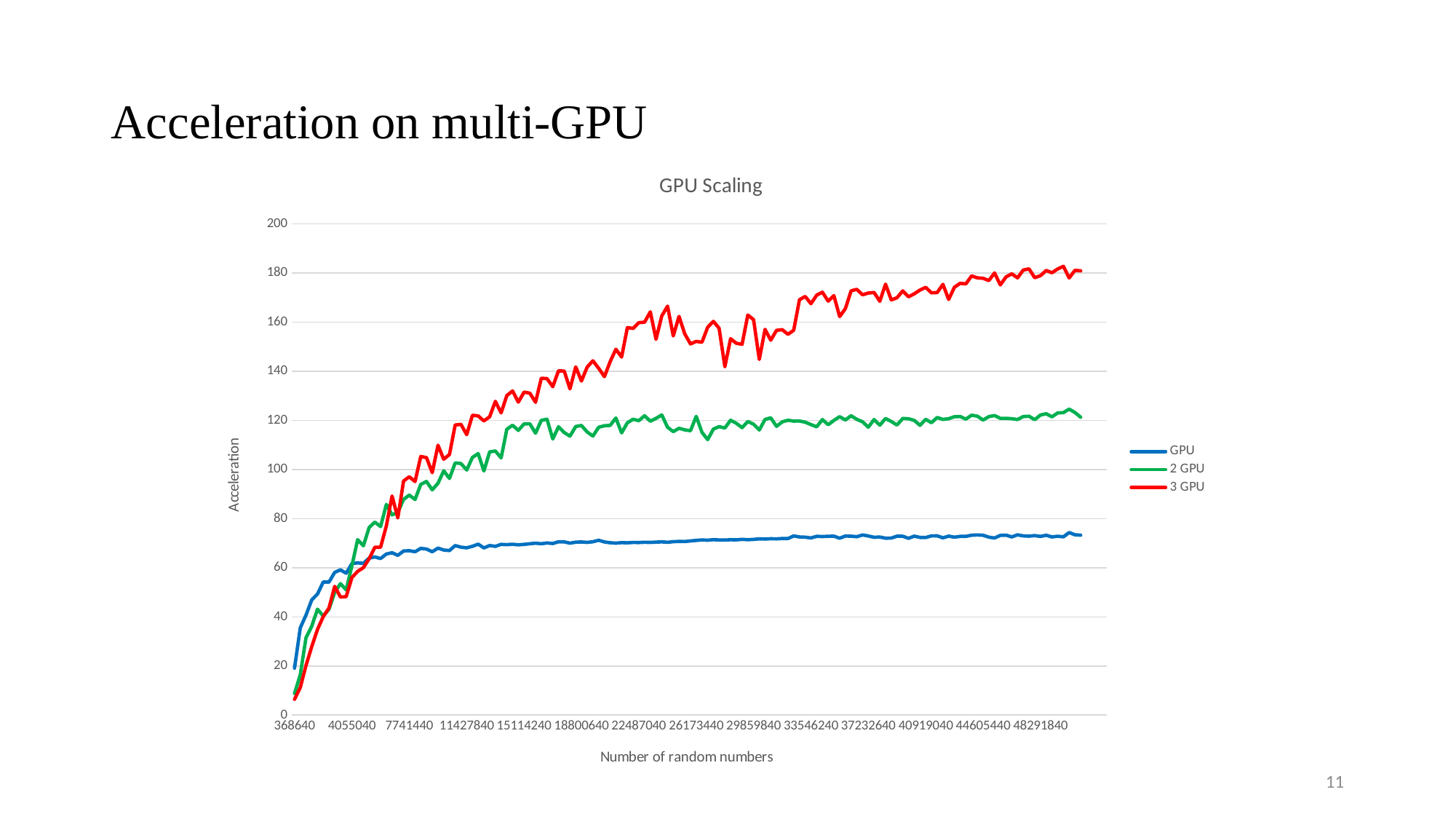
Is the value for 3 GPU at 48291840 greater or less than 160? greater What is the label of the vertical axis? Acceleration Is the value for 2 GPU at 48291840 greater or less than 100? greater What is the title of the chart? GPU Scaling Is the value for 3 GPU at 368640 greater or less than 20? less How many series does the legend of the GPU Scaling chart list? 3 What kind of chart is shown on the slide? line chart Does the acceleration for 3 GPU generally rise or fall as the number of random numbers increases? rise At 368640, which series has the larger acceleration, GPU or 3 GPU? GPU At 48291840, which series has the larger acceleration, 2 GPU or 3 GPU? 3 GPU Which series reaches the highest acceleration on the chart? 3 GPU